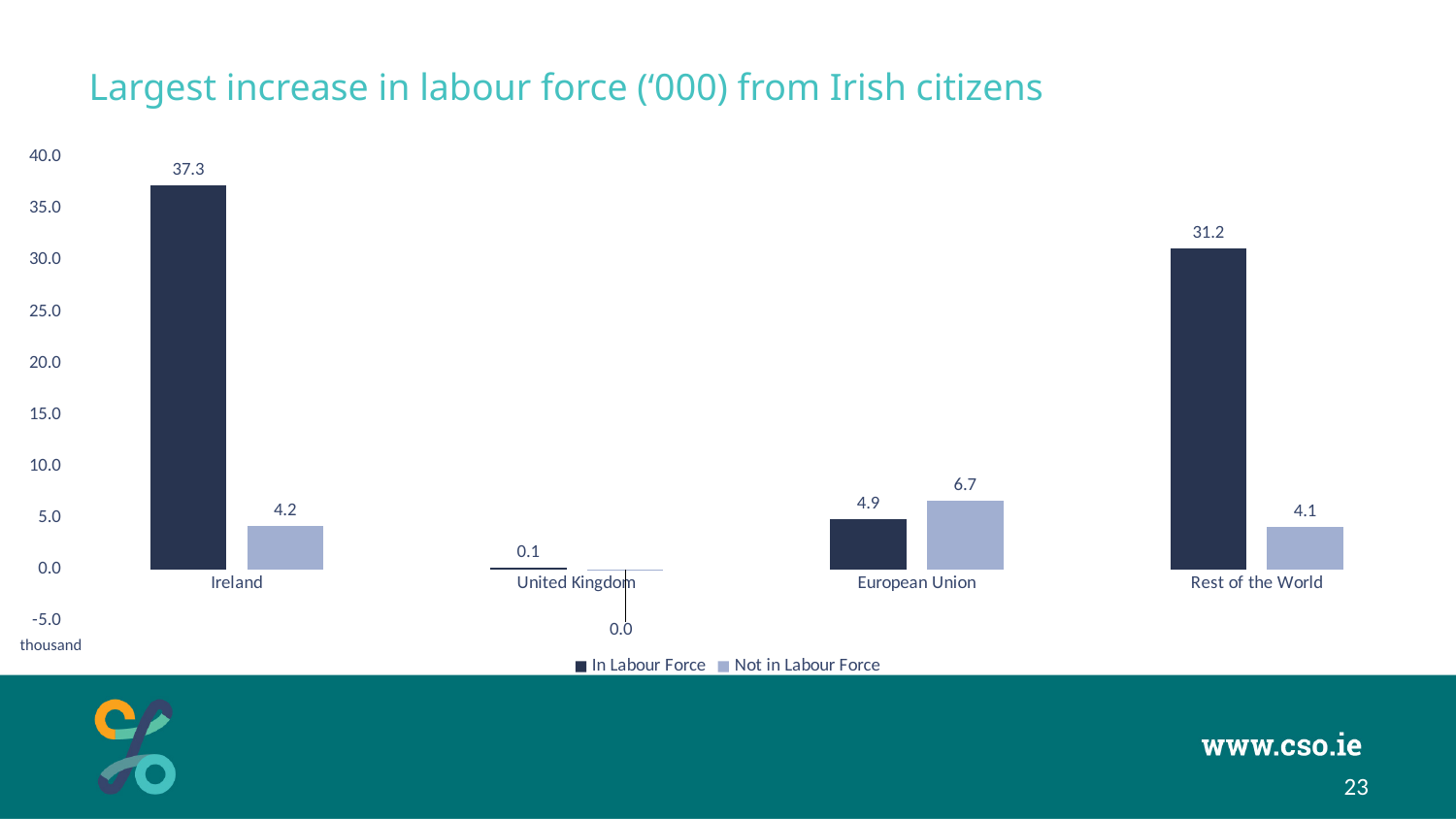
What is the 'Not in Labour Force' value for European Union? 6.7 What is the difference between the 'In Labour Force' values for Ireland and Rest of the World? 6.1 Which category has the lowest 'In Labour Force' value? United Kingdom Which category has the highest 'In Labour Force' value? Ireland What kind of chart is shown on the slide? Bar chart How many series does the legend list? 2 What is the 'In Labour Force' value for Ireland? 37.3 What is the 'In Labour Force' value for Rest of the World? 31.2 What is the title of the chart? Largest increase in labour force ('000) from Irish citizens For European Union, which is larger: 'In Labour Force' or 'Not in Labour Force'? Not in Labour Force How many categories are shown on the x axis? 4 What is the 'Not in Labour Force' value for Rest of the World? 4.1